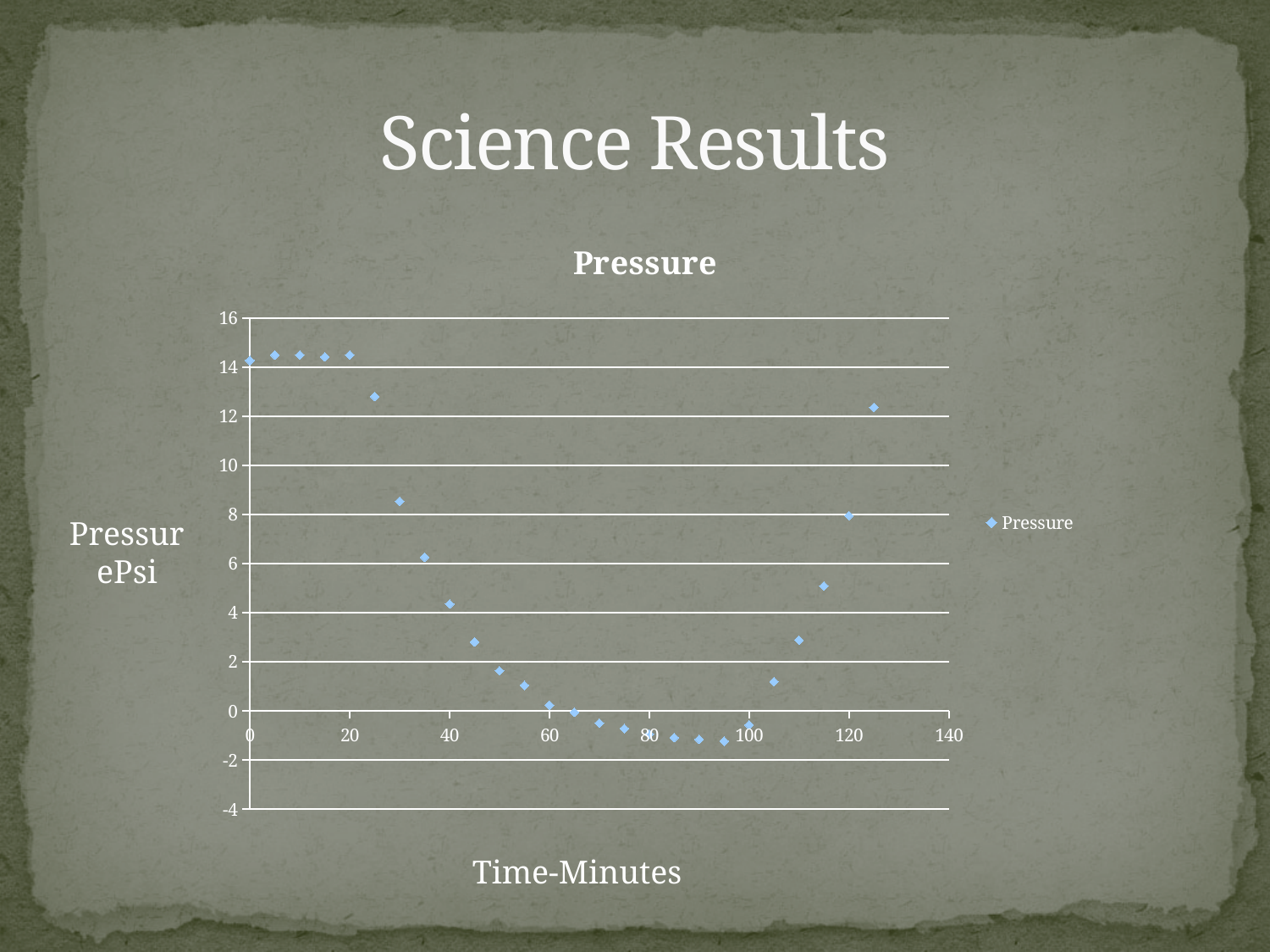
Is the pressure value at 125 minutes greater or less than 10? greater Do the pressure values rise or fall between 20 and 60 minutes? fall Is the pressure value at 25 minutes greater or less than 12? greater Is the pressure value at 90 minutes greater or less than 0? less What is the title of the chart? Pressure Do the pressure values rise or fall between 100 and 125 minutes? rise Which is larger, the pressure value at 10 minutes or at 110 minutes? 10 minutes What is the label on the x axis of the chart? Time-Minutes What kind of chart is shown on the slide? scatter chart How many series does the legend list? 1